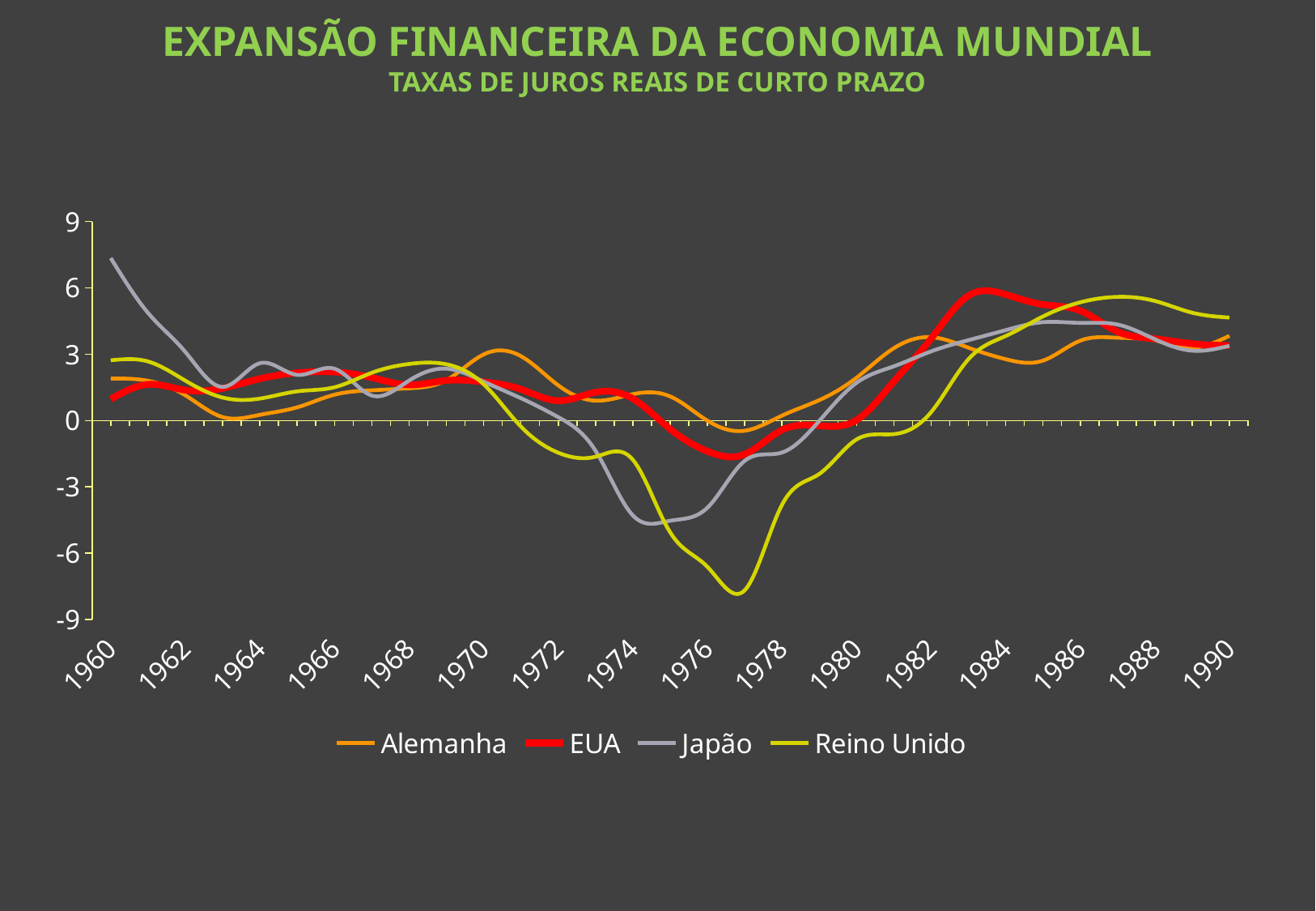
Which series are listed in the legend? Alemanha, EUA, Japão, Reino Unido What kind of chart is shown on the slide? line chart Which series has the highest value in 1960? Japão Is the value for Japão in 1975 greater or less than -3? less Is the value for EUA in 1984 greater or less than 3? greater How many series does the legend list? 4 Which series reaches the lowest value anywhere on the chart? Reino Unido What is the subtitle of the chart? TAXAS DE JUROS REAIS DE CURTO PRAZO Is the value for Reino Unido in 1977 greater or less than -6? less In 1976, which is larger: the value for EUA or the value for Reino Unido? EUA How many year labels are shown on the x axis? 16